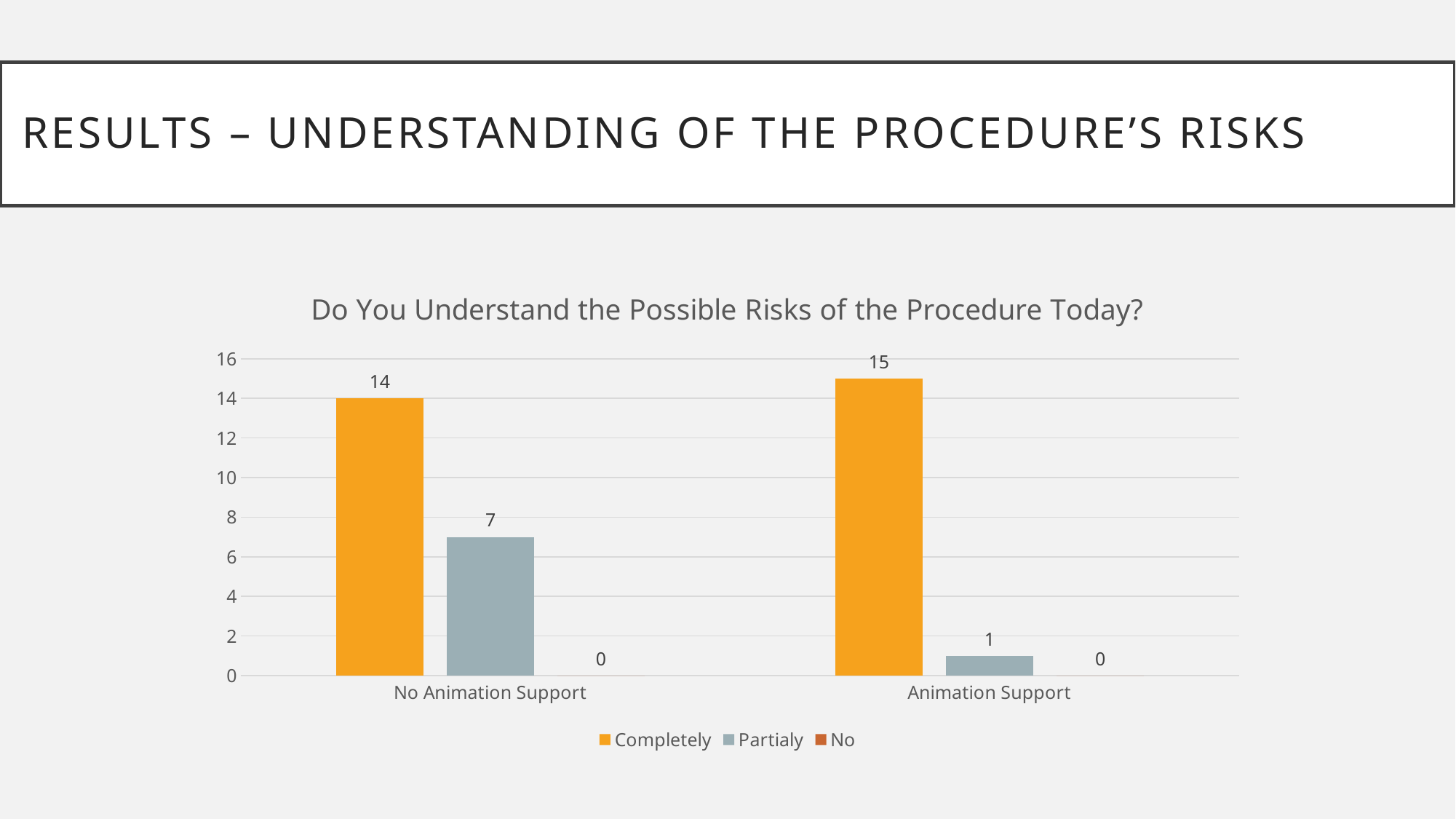
What is the value for No in the No Animation Support group? 0 How many series does the legend list? 3 What kind of chart is shown on the slide? Bar chart What is the value for Partialy in the Animation Support group? 1 What is the value for Completely in the Animation Support group? 15 How many categories are shown on the x axis? 2 What is the difference between the Partialy values for No Animation Support and Animation Support? 6 Which series has the lowest value in the No Animation Support group? No What is the value for Completely in the No Animation Support group? 14 Which is larger: Completely for No Animation Support or Completely for Animation Support? Animation Support What is the title of the chart? Do You Understand the Possible Risks of the Procedure Today? Which series has the highest value in the Animation Support group? Completely